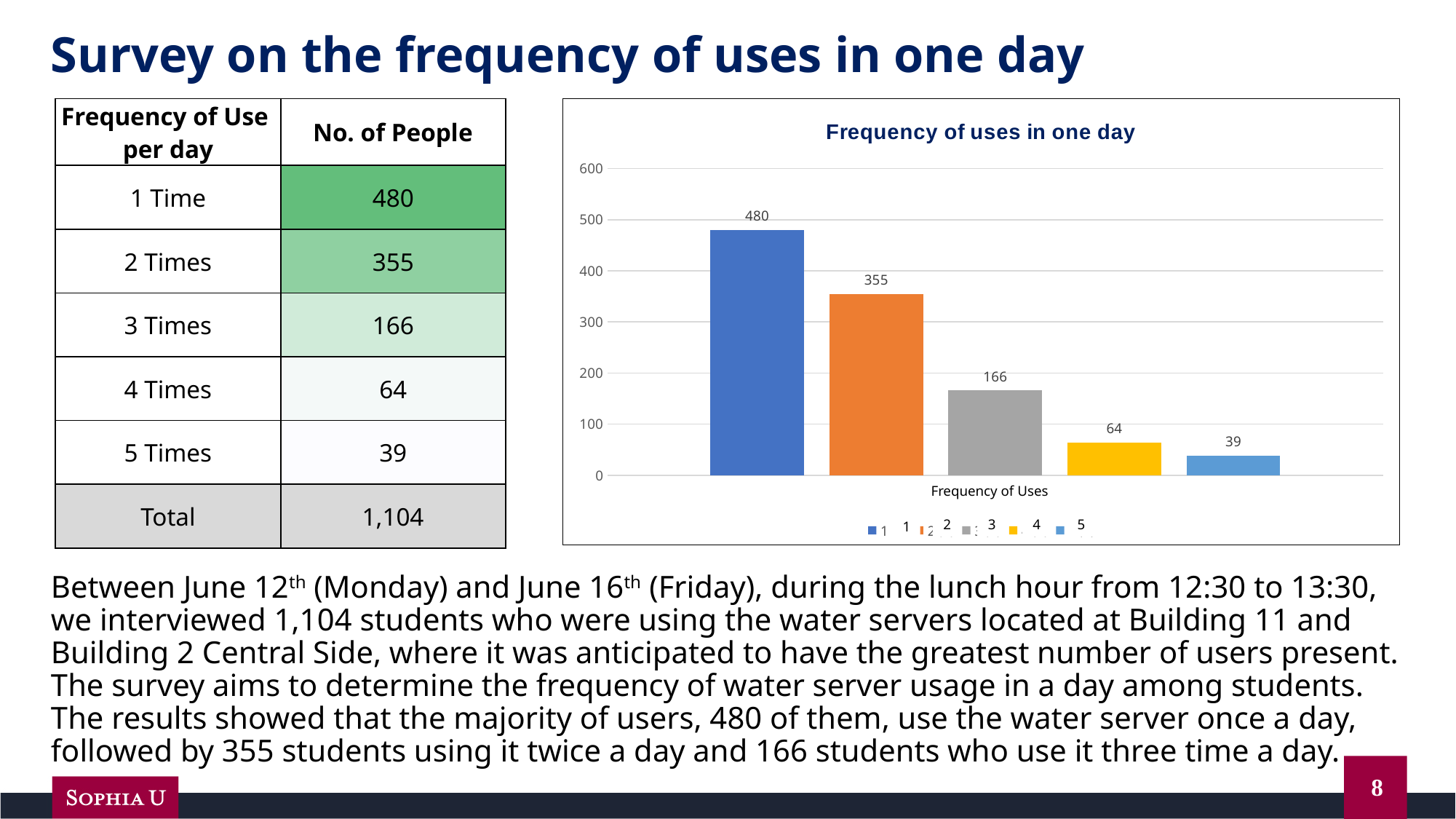
Is the value for series 2 greater or less than 400? less Which series has the lowest bar in the chart? 5 What is the value of the bar for series 3 in the chart? 166 What kind of chart is shown on the slide? bar chart Which series has the highest bar in the chart? 1 What is the difference between the values for series 1 and series 2? 125 Which is larger, the value for series 3 or the value for series 4? series 3 What is the title of the chart? Frequency of uses in one day What is the value of the bar for series 5 in the chart? 39 What is the value of the bar for series 1 in the chart? 480 How many series does the legend list? 5 Do the bar values rise or fall from series 1 to series 5? fall